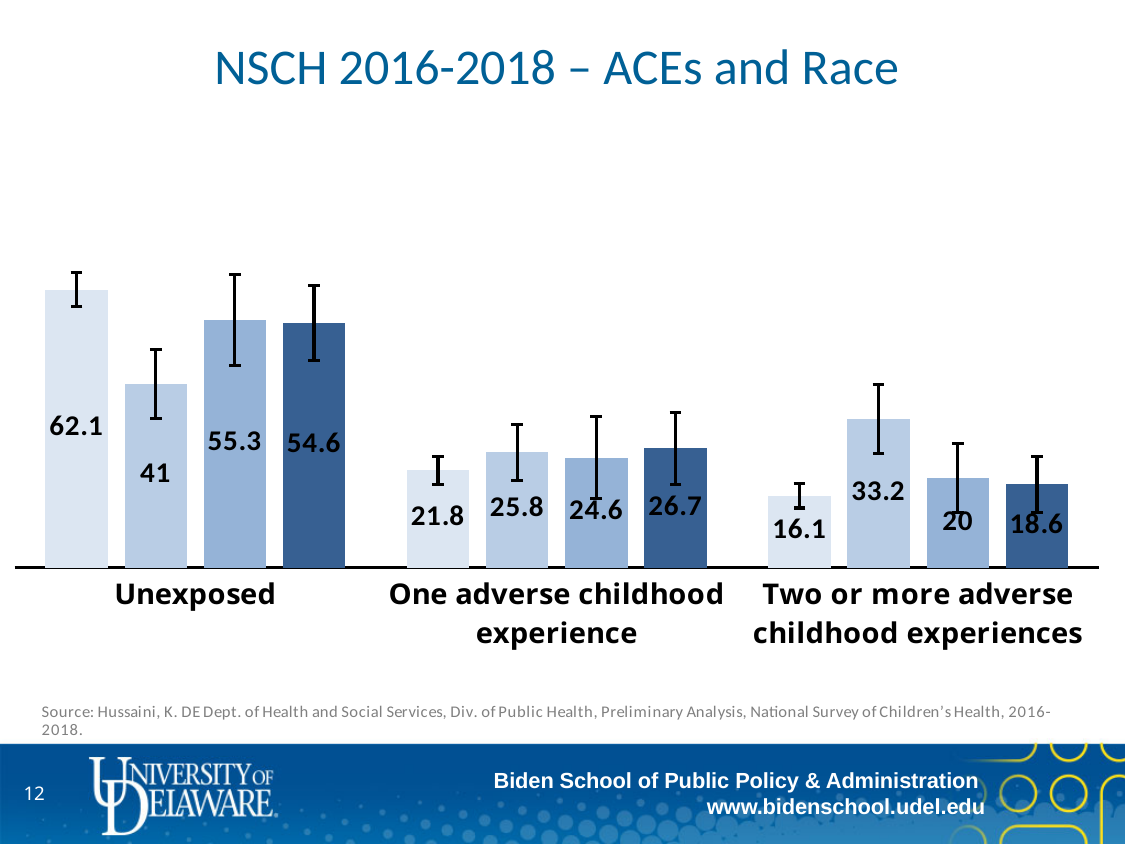
How many categories are shown along the x axis? 3 What is the value of the second bar in the Two or more adverse childhood experiences group? 33.2 Which bar has the highest value in the Unexposed group? the first (lightest) bar, 62.1 Which bar has the lowest value in the Two or more adverse childhood experiences group? the first (lightest) bar, 16.1 What is the value of the first (lightest) bar in the Unexposed group? 62.1 What is the value of the second bar in the Unexposed group? 41 What is the difference between the first and second bars in the Unexposed group? 21.1 Do the values of the lightest bars fall or rise moving from Unexposed to Two or more adverse childhood experiences? fall How many bars are plotted in each category group? 4 In the Two or more adverse childhood experiences group, which is larger: the second bar or the third bar? the second bar (33.2) What kind of chart is shown on the slide? bar chart What is the value of the darkest bar in the One adverse childhood experience group? 26.7